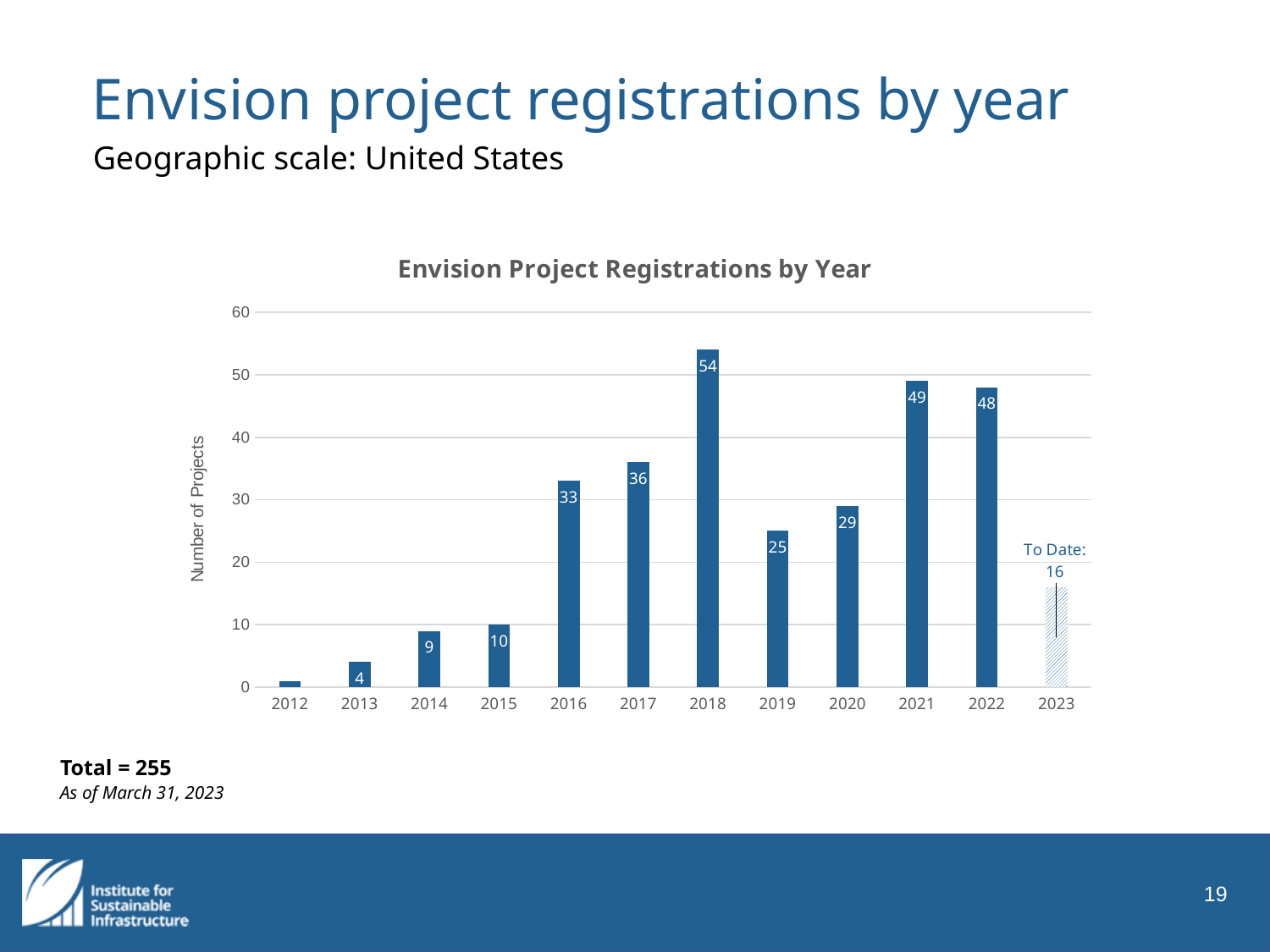
What is the difference between the 2017 and 2016 values? 3 How many projects were registered in 2018? 54 Which year has the highest number of project registrations? 2018 What is the 'To Date' value shown for 2023? 16 What is the difference between the number of projects in 2018 and in 2021? 5 Which year has the lowest number of project registrations? 2012 What kind of chart is shown on the slide? bar chart How many years are shown on the x axis of the chart? 12 Is the value for 2012 greater or less than 10? less What is the title of the chart? Envision Project Registrations by Year Which year had more registrations, 2016 or 2019? 2016 What is the number of projects for 2014? 9